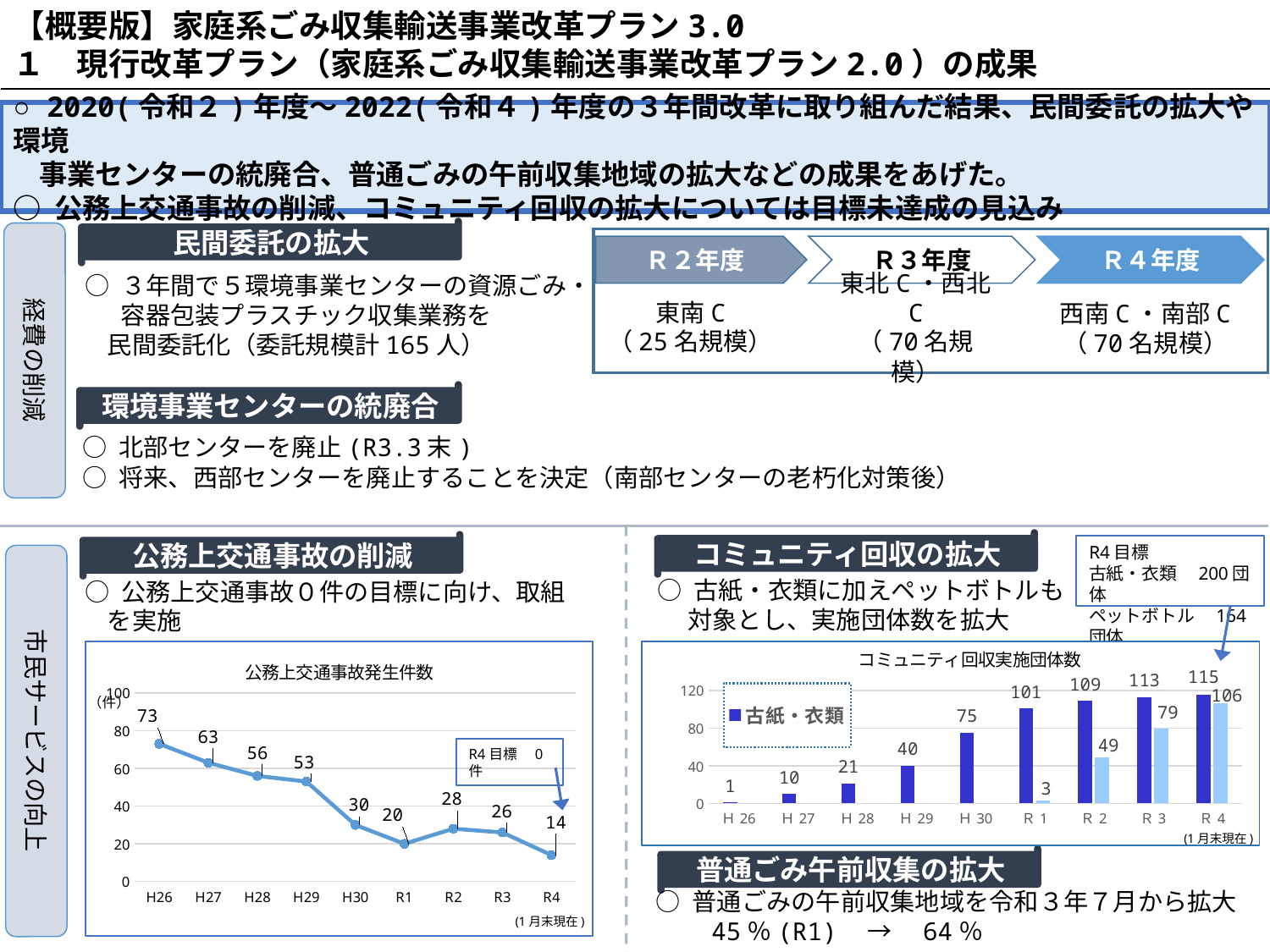
What type of chart is the 公務上交通事故発生件数 chart? line chart In the コミュニティ回収実施団体数 chart, which year has the highest 古紙・衣類 value? R4 In the 公務上交通事故発生件数 chart, do the values generally rise or fall from H26 to R4? fall In the 公務上交通事故発生件数 chart, what is the value for H26? 73 In the コミュニティ回収実施団体数 chart, is the light blue bar for R3 larger or smaller than the light blue bar for R2? larger In the コミュニティ回収実施団体数 chart, what is the 古紙・衣類 value for H30? 75 In the 公務上交通事故発生件数 chart, how many years are plotted on the x axis? 9 What type of chart is the コミュニティ回収実施団体数 chart? bar chart In the 公務上交通事故発生件数 chart, what is the difference between H29 and H30? 23 In the 公務上交通事故発生件数 chart, which year has the lowest value? R4 In the 公務上交通事故発生件数 chart, what is the value for R4? 14 In the コミュニティ回収実施団体数 chart, what is the difference between the 古紙・衣類 values for R1 and H30? 26